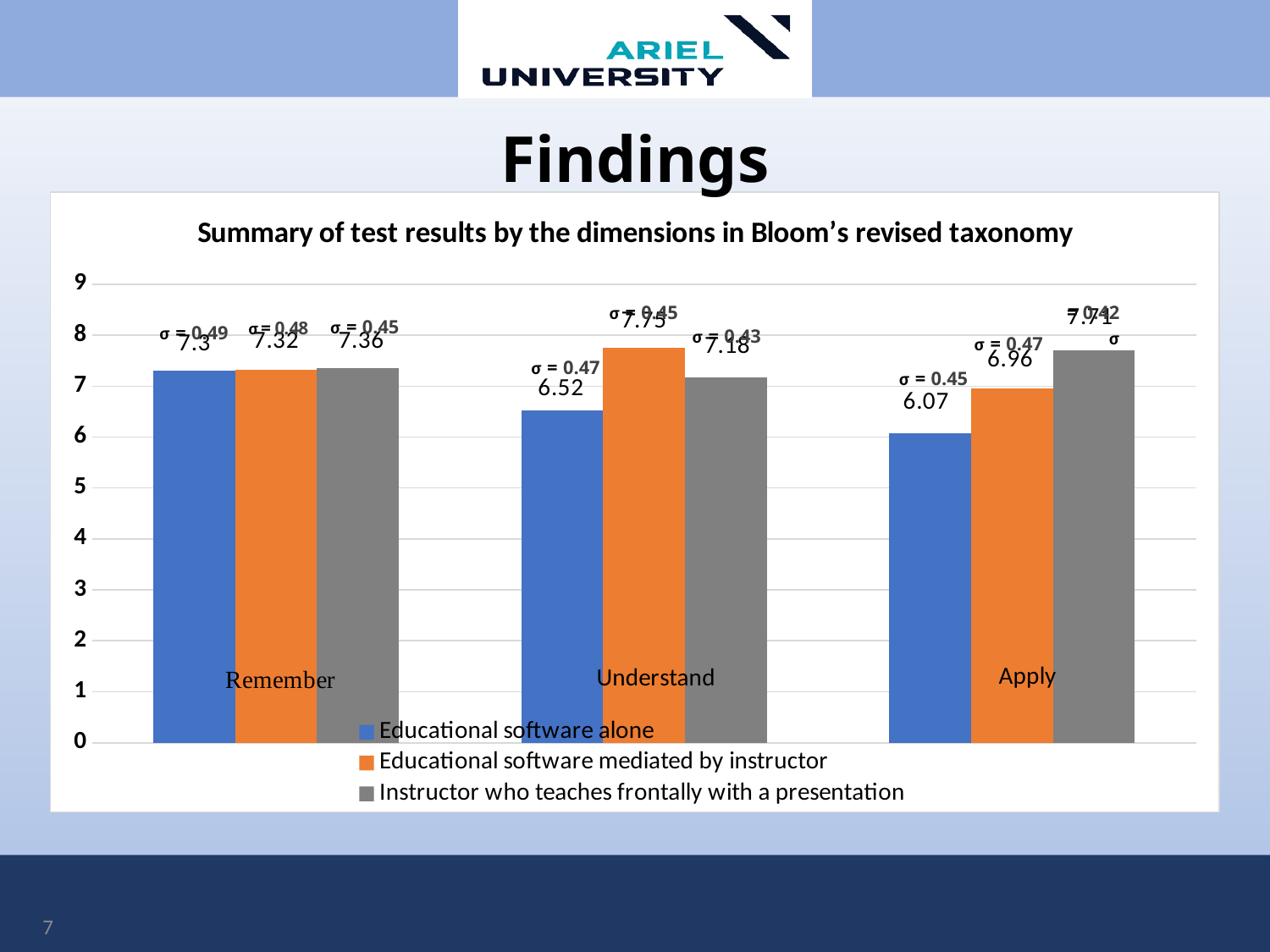
What is the value for Educational software mediated by instructor in the Apply category? 6.96 What is the value for Instructor who teaches frontally with a presentation in the Understand category? 7.18 What kind of chart is shown on the slide? Bar chart What is the value for Educational software alone in the Remember category? 7.3 How many series does the legend list? 3 Which category has the highest value for Educational software mediated by instructor? Understand In the Apply category, which is larger: Educational software alone or Instructor who teaches frontally with a presentation? Instructor who teaches frontally with a presentation How many categories are shown on the x axis? 3 Is the value for Educational software alone in the Apply category greater or less than 7? less What is the difference between Educational software mediated by instructor and Educational software alone in the Understand category? 1.23 What is the value for Educational software alone in the Understand category? 6.52 Which category has the lowest value for Educational software alone? Apply